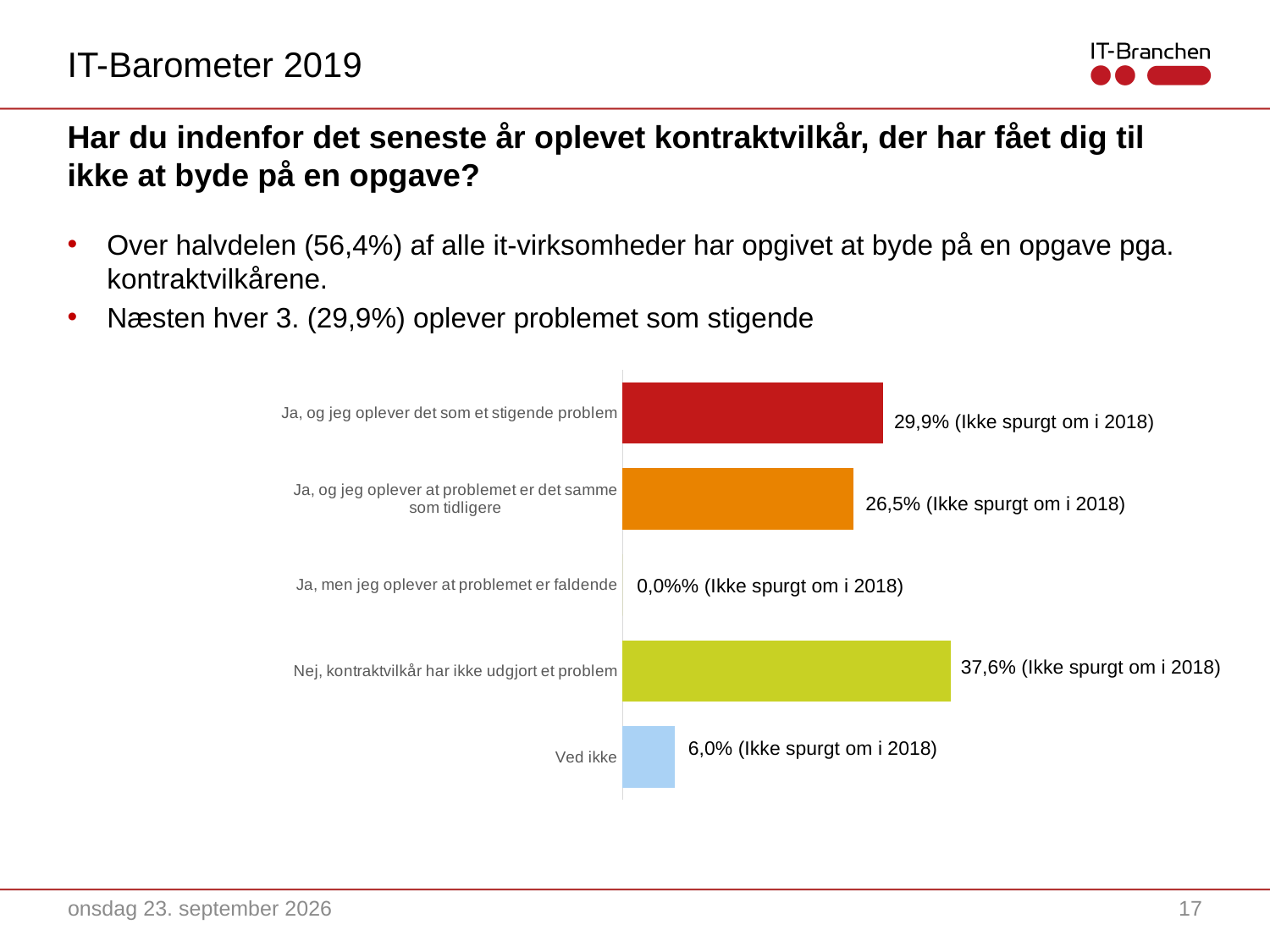
What kind of chart is shown on the slide? Bar chart How many categories are shown in the chart? 5 What percentage is shown for "Ja, og jeg oplever at problemet er det samme som tidligere"? 26,5% What percentage is shown for "Nej, kontraktvilkår har ikke udgjort et problem"? 37,6% What percentage is shown for "Ved ikke"? 6,0% Which category has the lowest value in the chart? Ja, men jeg oplever at problemet er faldende What is the difference between the values for "Nej, kontraktvilkår har ikke udgjort et problem" and "Ja, og jeg oplever det som et stigende problem"? 7,7% Which category has the highest value in the chart? Nej, kontraktvilkår har ikke udgjort et problem What is the difference between the values for "Ja, og jeg oplever det som et stigende problem" and "Ja, og jeg oplever at problemet er det samme som tidligere"? 3,4% What colour is the bar for "Ja, og jeg oplever det som et stigende problem"? Red What percentage is shown for "Ja, og jeg oplever det som et stigende problem"? 29,9% Which is larger: the value for "Ja, og jeg oplever det som et stigende problem" or the value for "Ved ikke"? Ja, og jeg oplever det som et stigende problem